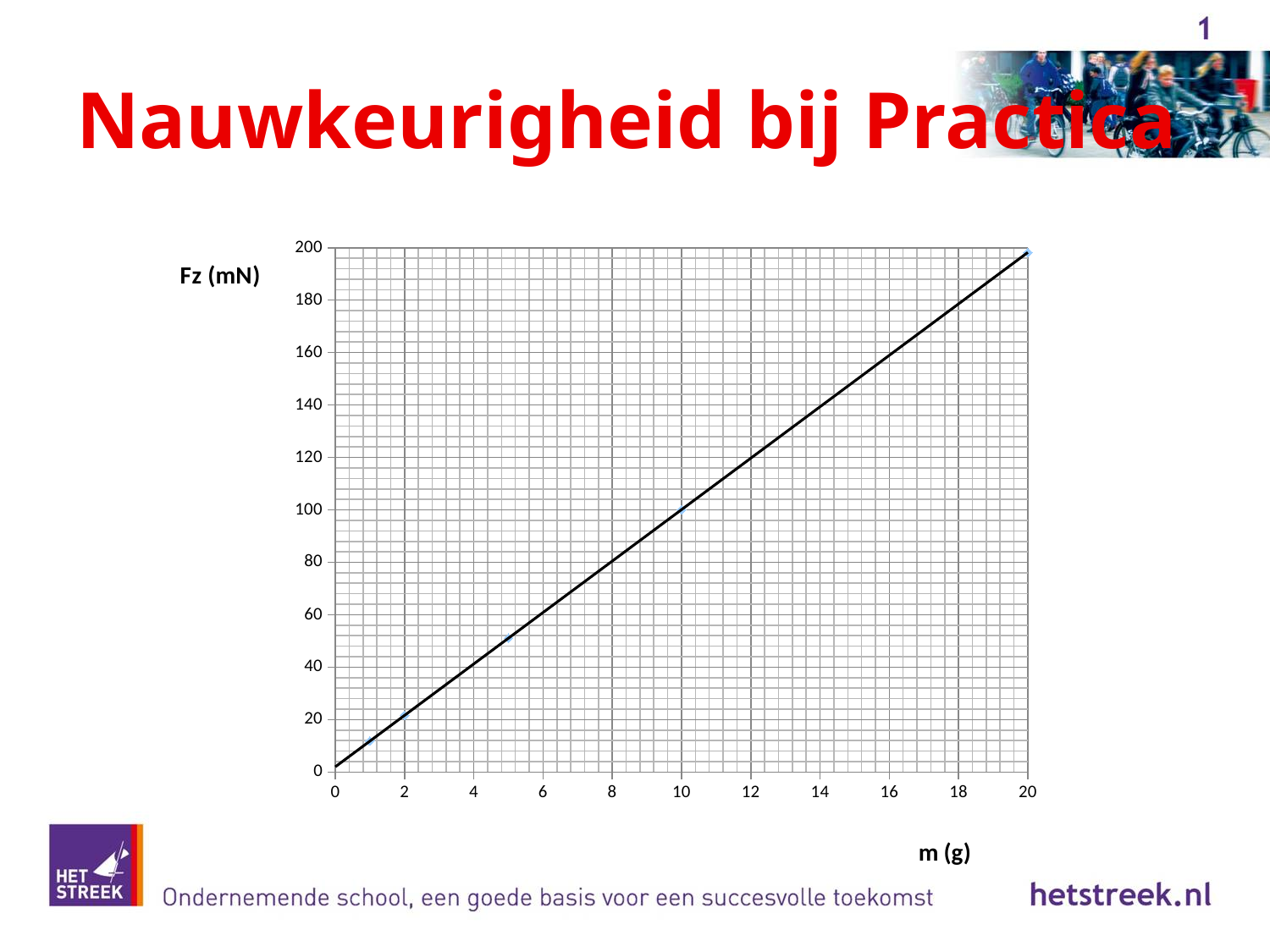
Is the value of Fz at m = 5 greater or less than 60? less Is the value of Fz at m = 20 greater or less than 180? greater Do the values of Fz rise or fall as m increases along the x axis? rise Is the value of Fz at m = 2 greater or less than 40? less What is the label of the horizontal axis? m (g) What kind of chart is shown on the slide? line chart What is the label of the vertical axis? Fz (mN) Which is larger, the value of Fz at m = 10 or at m = 5? m = 10 At which value of m is Fz highest on the chart? 20